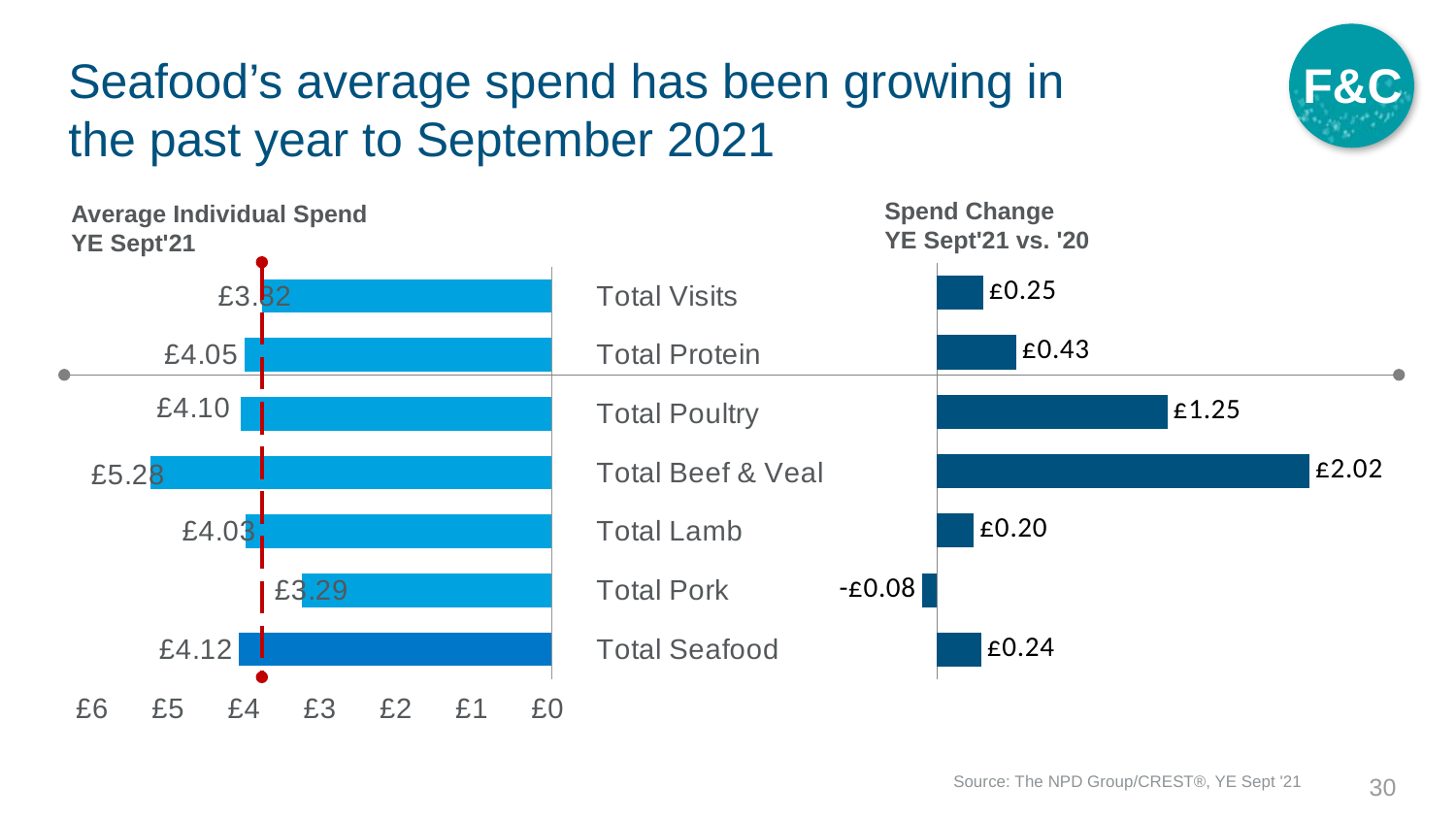
What kind of chart is the Spend Change YE Sept'21 vs. '20 chart? Bar chart In the Spend Change YE Sept'21 vs. '20 chart, what is the value for Total Poultry? £1.25 In the Spend Change YE Sept'21 vs. '20 chart, what is the difference between Total Beef & Veal and Total Poultry? £0.77 In the Spend Change YE Sept'21 vs. '20 chart, what is the value for Total Pork? -£0.08 In the Spend Change YE Sept'21 vs. '20 chart, which is larger, Total Protein or Total Lamb? Total Protein In the Spend Change YE Sept'21 vs. '20 chart, which category has the highest value? Total Beef & Veal In the Average Individual Spend YE Sept'21 chart, which category has the lowest value? Total Pork In the Average Individual Spend YE Sept'21 chart, what is the value for Total Seafood? £4.12 In the Average Individual Spend YE Sept'21 chart, which category has the highest value? Total Beef & Veal In the Average Individual Spend YE Sept'21 chart, what is the difference between Total Beef & Veal and Total Pork? £1.99 How many categories are shown in the Average Individual Spend YE Sept'21 chart? 7 In the Average Individual Spend YE Sept'21 chart, what is the value for Total Beef & Veal? £5.28